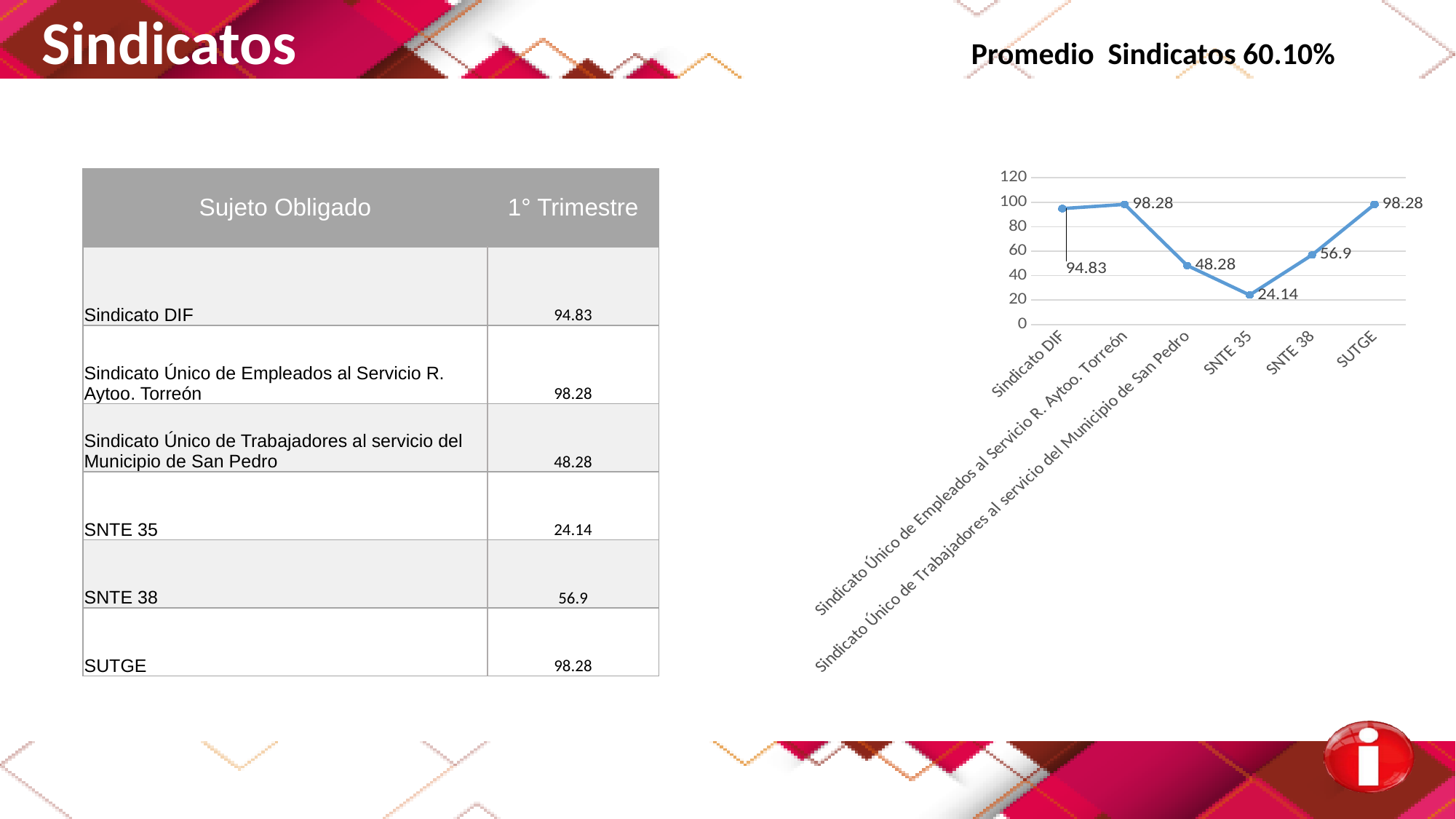
What is the highest tick value shown on the y axis of the chart? 120 Which category has the lowest value in the chart? SNTE 35 What is the value for Sindicato Único de Trabajadores al servicio del Municipio de San Pedro? 48.28 What is the difference between the values for SUTGE and SNTE 35? 74.14 Is the value for SNTE 35 greater or less than 40? less What type of chart is shown on the slide? line chart What is the value for SNTE 38 in the chart? 56.9 What is the difference between the values for SNTE 38 and Sindicato Único de Trabajadores al servicio del Municipio de San Pedro? 8.62 Which is larger, the value for Sindicato DIF or the value for SNTE 38? Sindicato DIF How many categories are plotted on the x axis of the chart? 6 What is the value for Sindicato DIF in the chart? 94.83 What is the value for SNTE 35 in the chart? 24.14